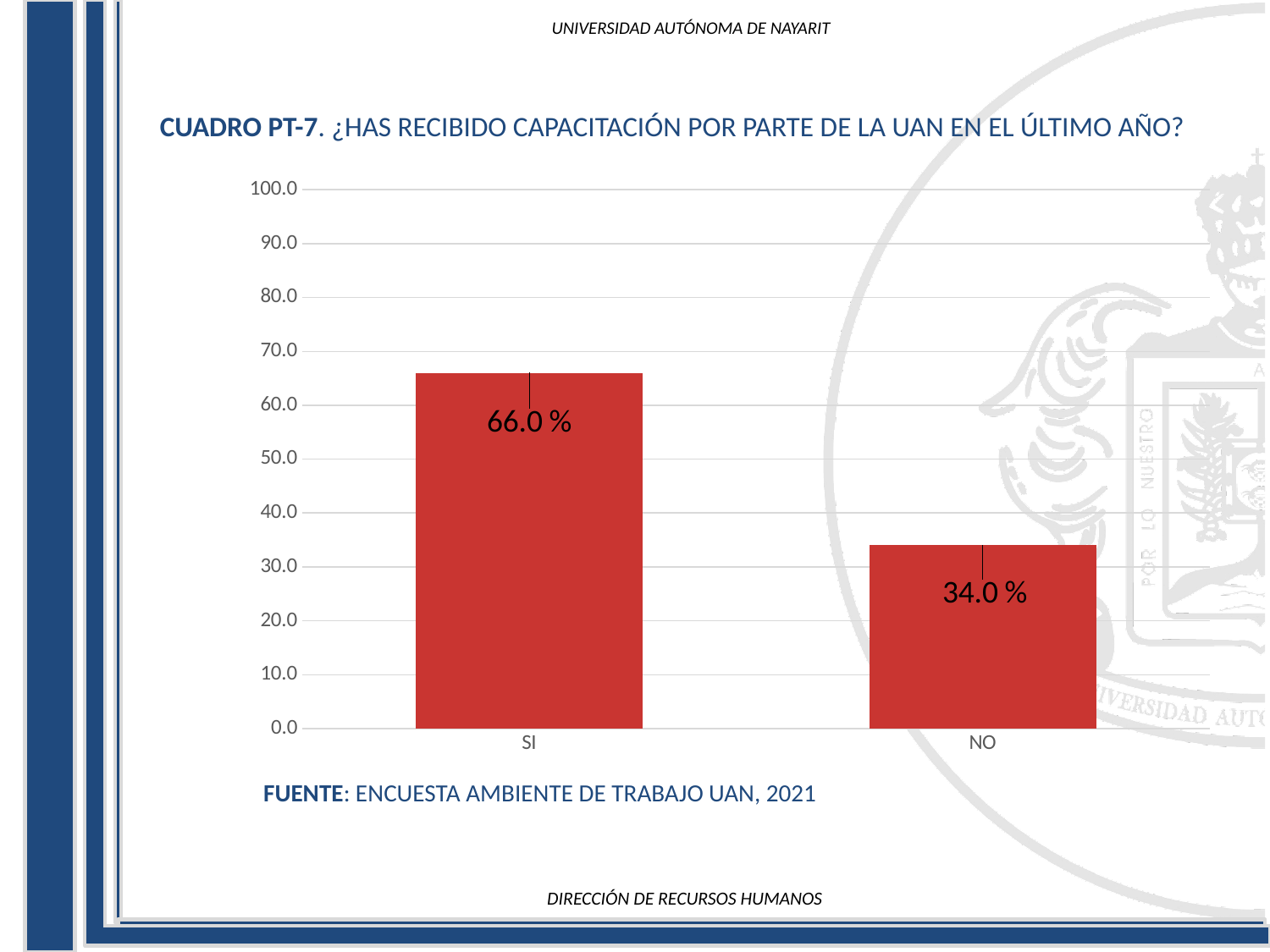
Is the value for SI greater or less than 60.0? greater What source is cited below the chart? ENCUESTA AMBIENTE DE TRABAJO UAN, 2021 How many categories are shown on the x axis? 2 Which category has the lowest value? NO What is the value for SI? 66.0 % What kind of chart is shown on the slide? bar chart What is the difference between the values for SI and NO? 32.0 % Which is larger, the value for SI or the value for NO? SI What is the value for NO? 34.0 % Is the value for NO greater or less than 40.0? less What is the maximum value shown on the y axis? 100.0 Which category has the highest value? SI